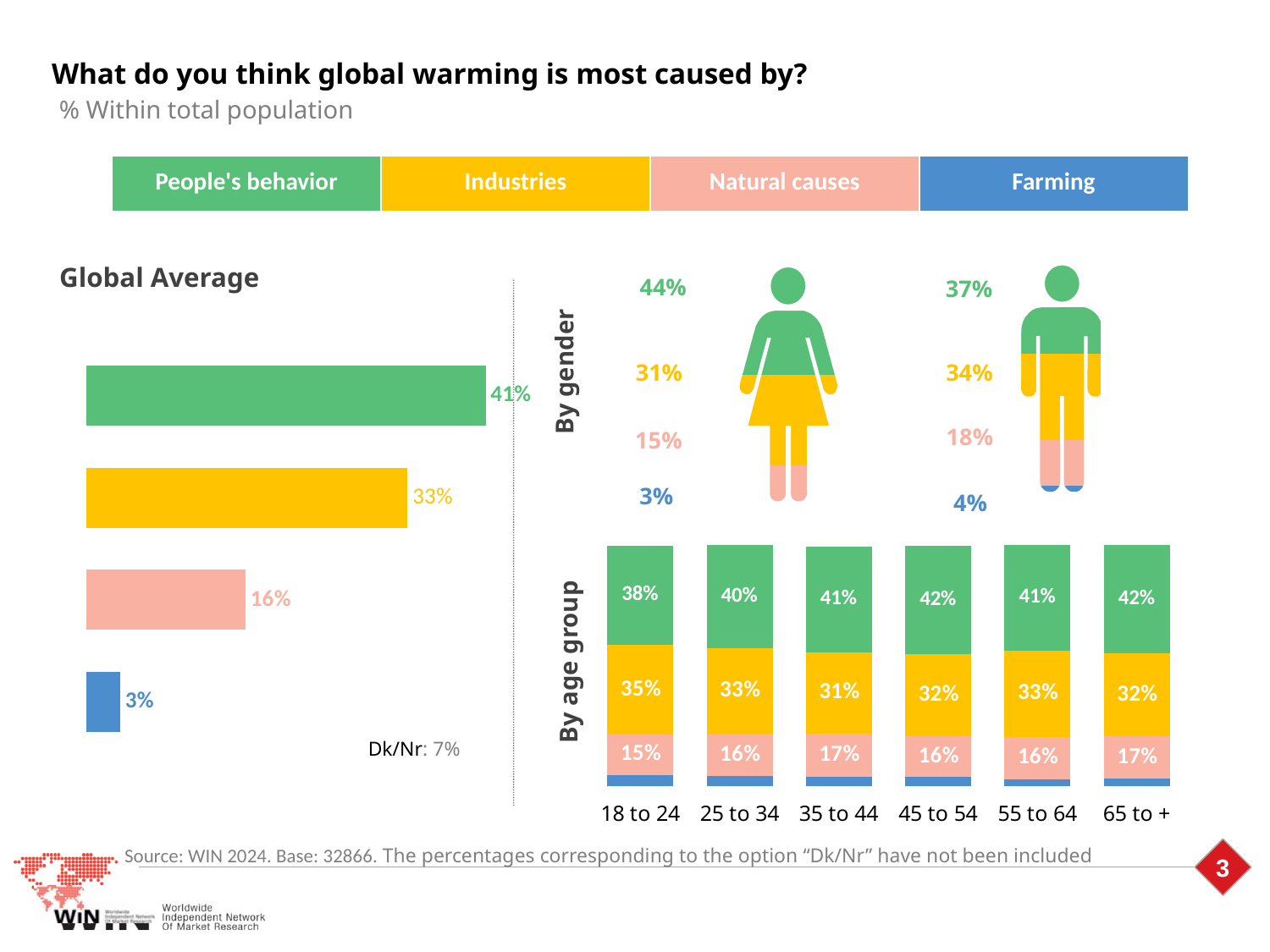
How many causes are plotted as bars in the Global Average chart? 4 In the By gender chart, what percentage of men chose Industries? 34% In the By age group chart, what percentage of the 35 to 44 group chose Industries? 31% In the By age group chart, what percentage of the 18 to 24 group chose People's behavior? 38% In the Global Average chart, what is the difference between the percentages for People's behavior and Industries? 8 percentage points How many age groups are shown in the By age group chart? 6 In the Global Average chart, which cause has the highest percentage? People's behavior In the Global Average chart, which cause has the lowest percentage? Farming In the By gender chart, who has the higher percentage for Natural causes, women or men? Men In the Global Average chart, what percentage is shown for Industries? 33% What kind of chart is the Global Average chart? Bar chart In the By gender chart, what percentage of women chose People's behavior? 44%